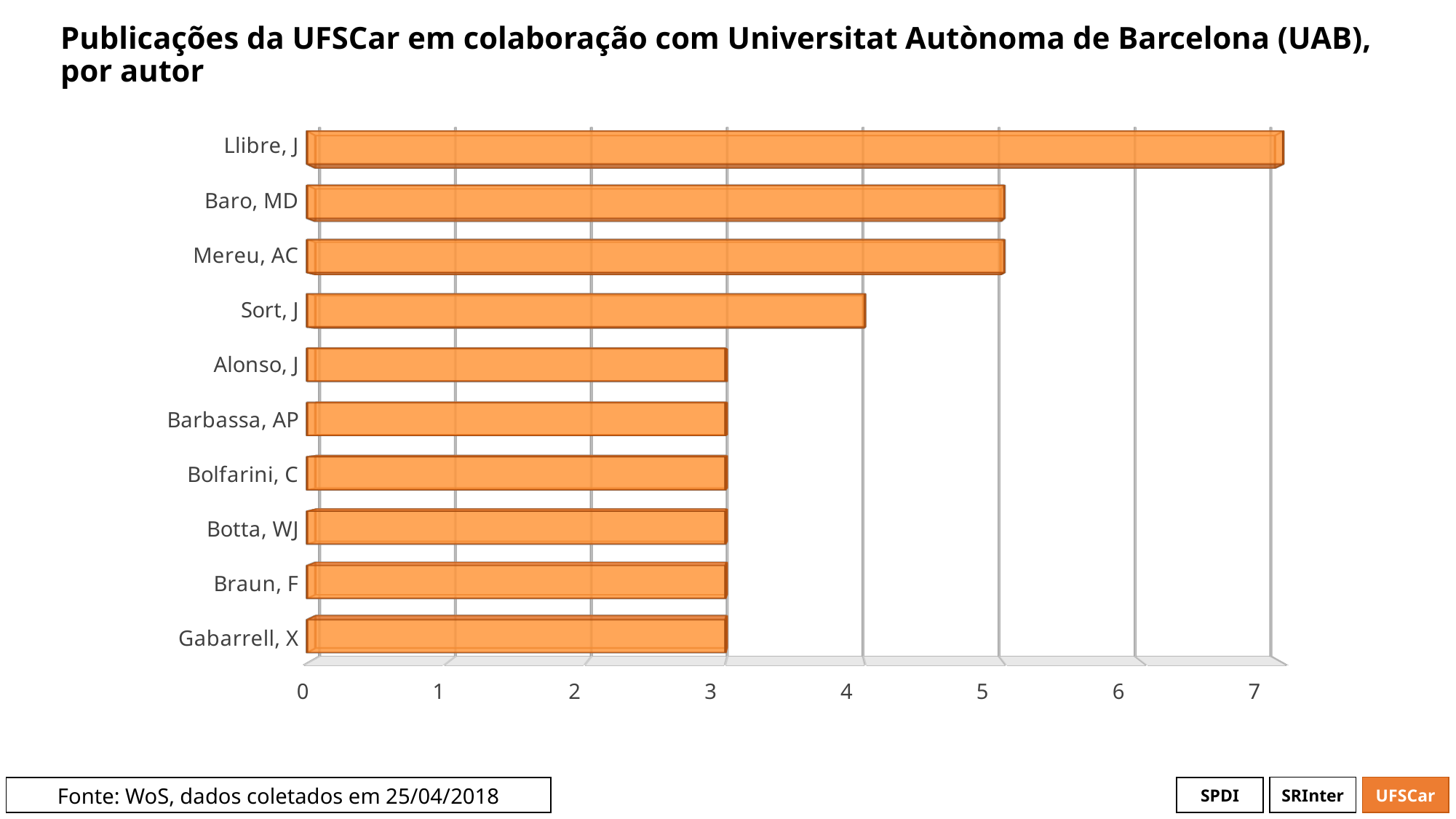
How many publications does Sort, J have? 4 How many authors are listed on the chart? 10 What is the title of the chart? Publicações da UFSCar em colaboração com Universitat Autònoma de Barcelona (UAB), por autor What is the difference between the values for Llibre, J and Sort, J? 3 Which author has the highest number of publications? Llibre, J Is the value for Sort, J greater or less than 5? less Is the value for Llibre, J greater or less than 6? greater How many publications does Gabarrell, X have? 3 How many publications does Llibre, J have? 7 How many publications does Baro, MD have? 5 Which is larger, the value for Sort, J or the value for Alonso, J? Sort, J What kind of chart is shown on the slide? bar chart